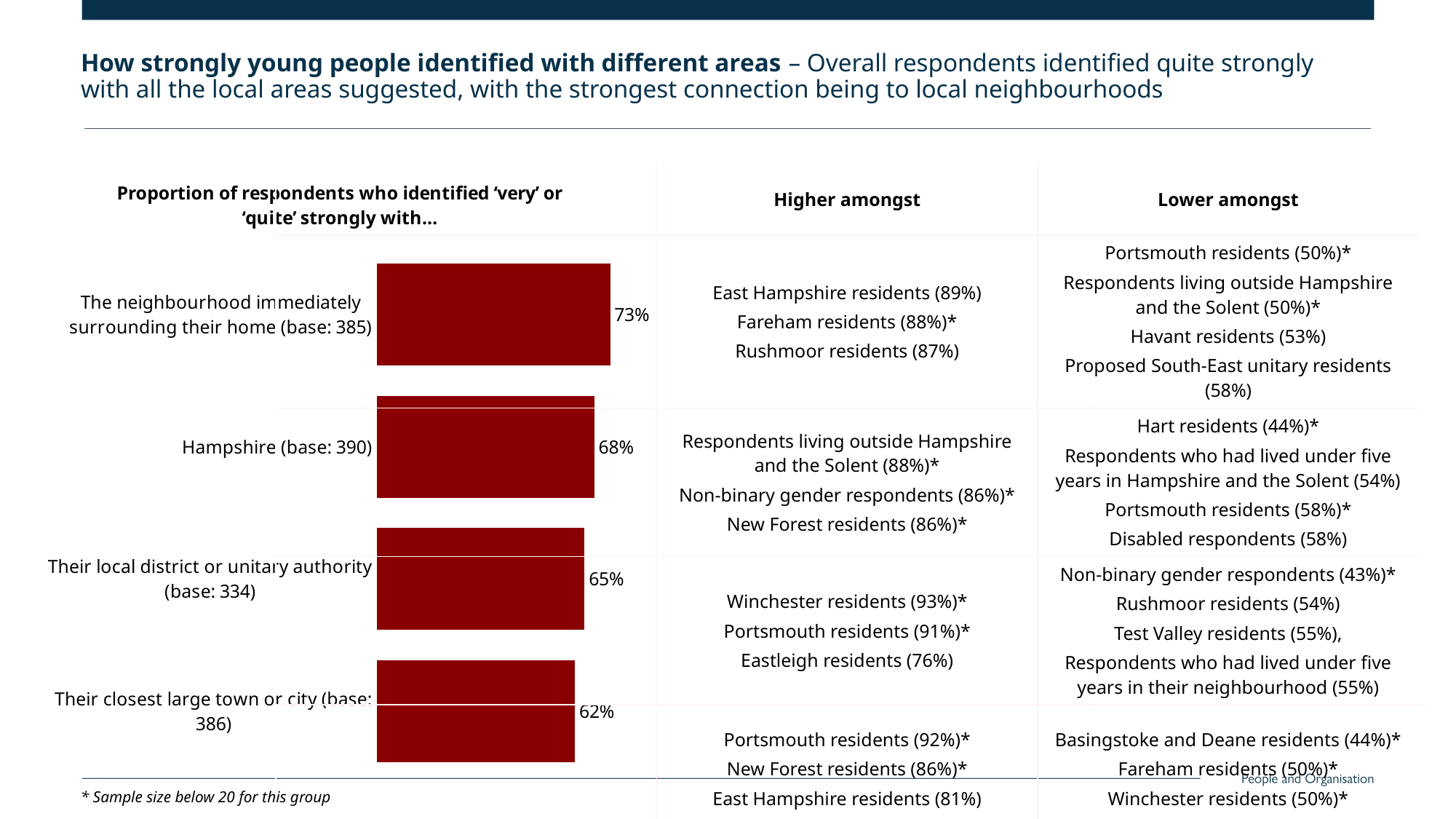
How many areas are shown as bars in the chart? 4 What proportion of respondents identified 'very' or 'quite' strongly with Hampshire? 68% What is the difference in percentage points between the proportion identifying strongly with Hampshire and with their local district or unitary authority? 3 percentage points What is the base (number of respondents) for the Hampshire bar? 390 What proportion of respondents identified 'very' or 'quite' strongly with the neighbourhood immediately surrounding their home? 73% What proportion of respondents identified 'very' or 'quite' strongly with their local district or unitary authority? 65% What type of chart is used to show the proportion of respondents identifying with different areas? Bar chart Which area has the lowest proportion of respondents identifying 'very' or 'quite' strongly with it? Their closest large town or city What is the difference in percentage points between the proportion identifying strongly with their neighbourhood and with their closest large town or city? 11 percentage points Which area has the highest proportion of respondents identifying 'very' or 'quite' strongly with it? The neighbourhood immediately surrounding their home Which is larger: the proportion identifying strongly with Hampshire or with their local district or unitary authority? Hampshire What proportion of respondents identified 'very' or 'quite' strongly with their closest large town or city? 62%